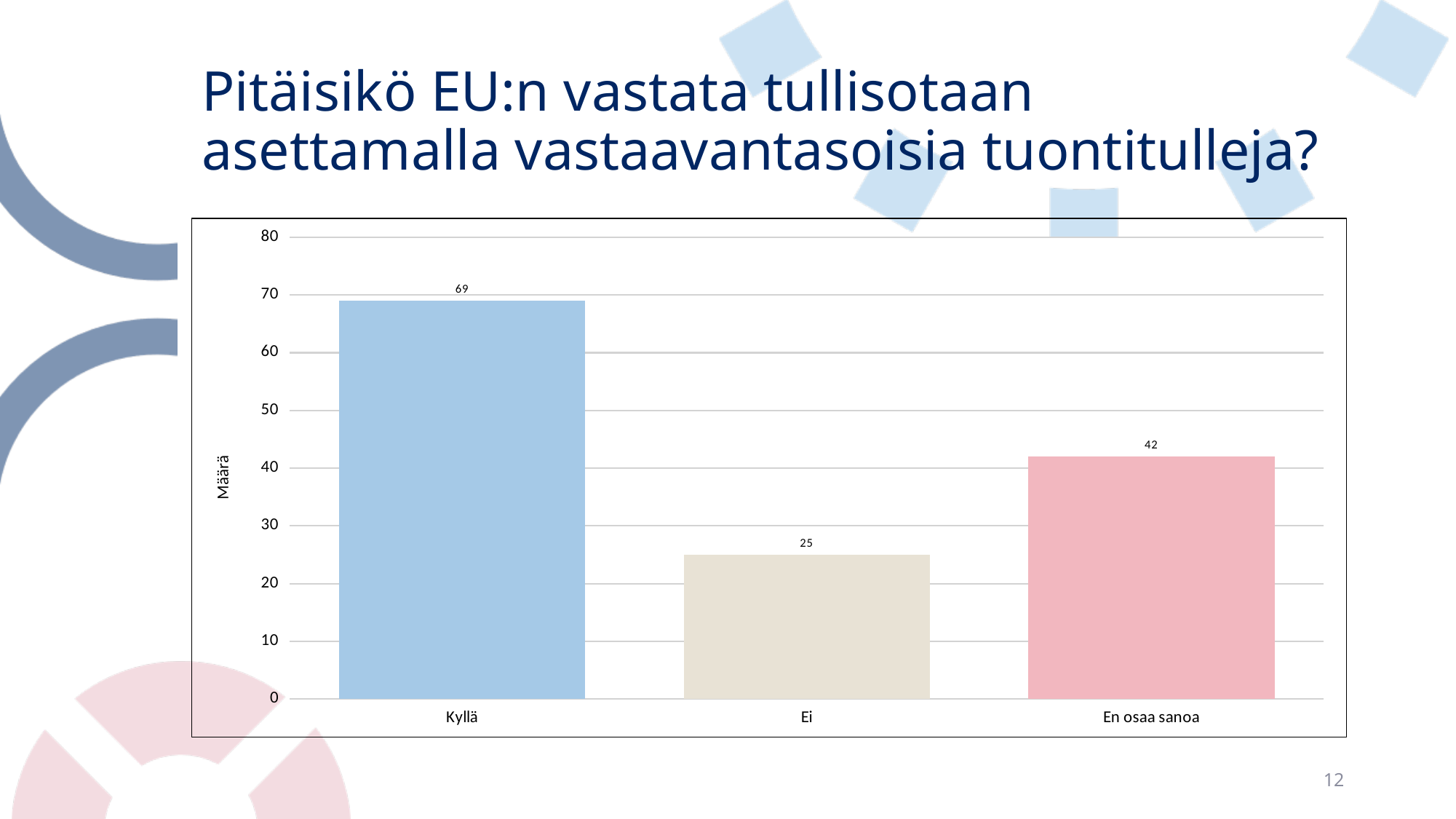
What is the difference between the values for En osaa sanoa and Ei? 17 Which category has the highest value? Kyllä Which is larger, the value for Ei or the value for En osaa sanoa? En osaa sanoa What is the difference between the values for Kyllä and Ei? 44 What kind of chart is shown on the slide? bar chart What is the label of the vertical axis? Määrä How many categories are shown on the x axis? 3 What is the value for Kyllä? 69 What is the value for Ei? 25 Which category has the lowest value? Ei Is the value for Kyllä greater or less than 60? greater What is the value for En osaa sanoa? 42